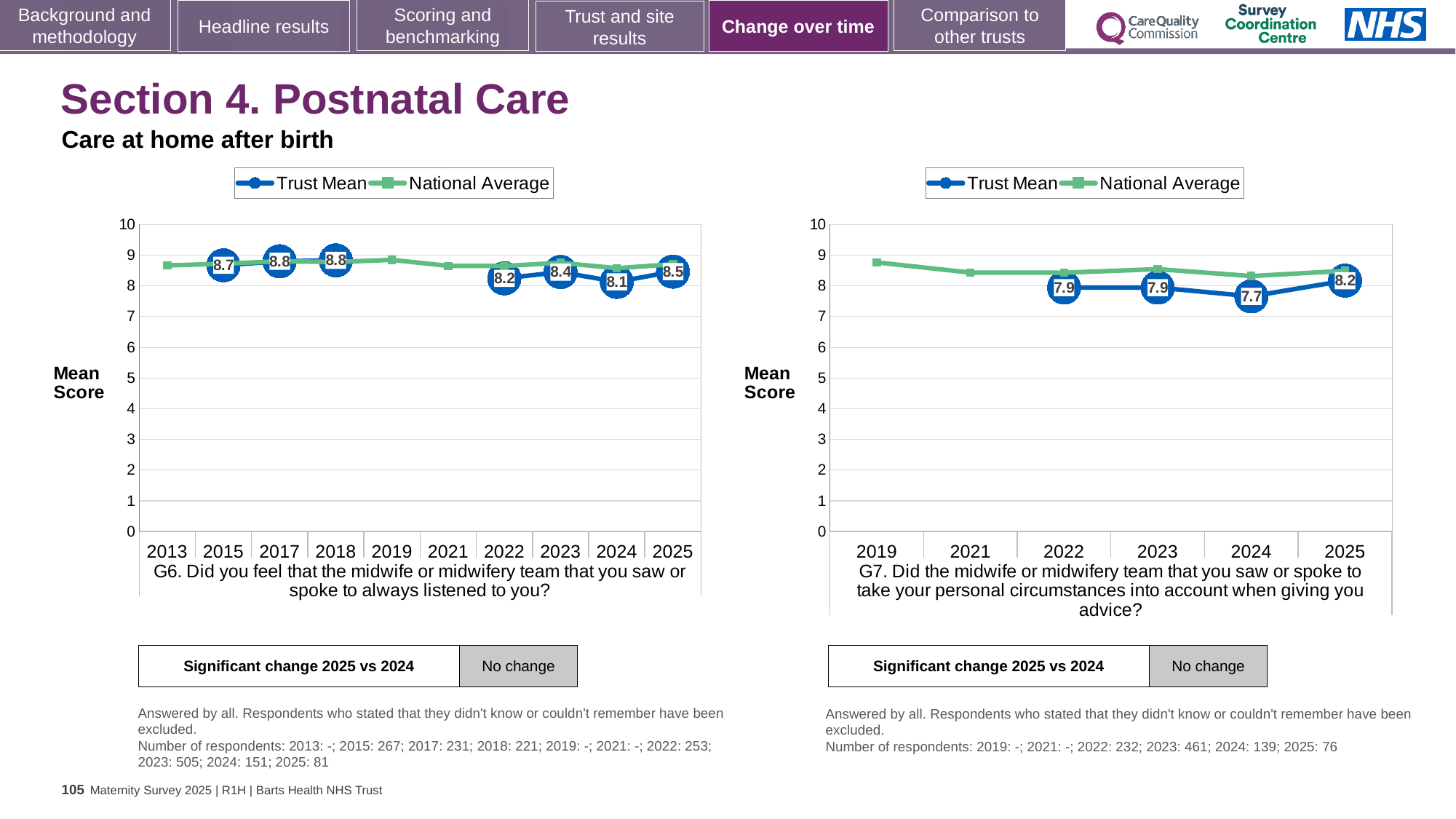
In the right chart (G7), what is the difference between the Trust Mean scores for 2025 and 2024? 0.5 What kind of chart is the right chart (G7)? Line chart In the left chart (G6), what is the Trust Mean score for 2024? 8.1 In the left chart (G6), how many years are shown on the x axis? 10 In the left chart (G6), by how much did the Trust Mean score change from 2024 to 2025? 0.4 In the right chart (G7), which year has the highest Trust Mean score? 2025 In the right chart (G7), what is the Trust Mean score for 2025? 8.2 In the right chart (G7), which year has the lowest Trust Mean score? 2024 In the left chart (G6), how many series does the legend list? 2 In the right chart (G7), is the National Average value for 2019 greater or less than 8? greater In the left chart (G6), what is the Trust Mean score for 2025? 8.5 In the left chart (G6), which year has the lowest Trust Mean score? 2024